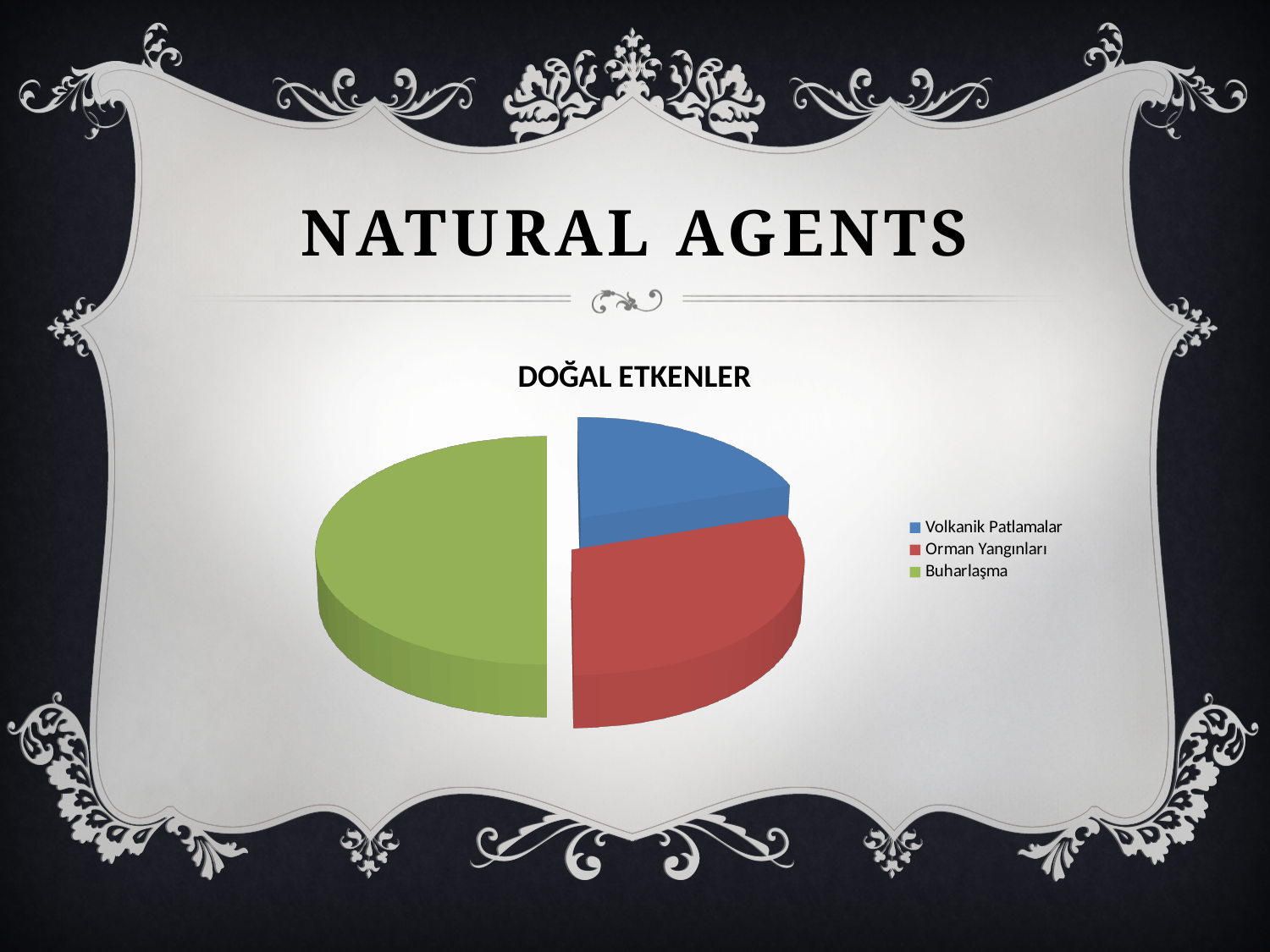
Which slice is larger, Buharlaşma or Orman Yangınları? Buharlaşma What kind of chart is shown on the slide? pie chart Which category has the largest slice of the pie? Buharlaşma Which slice is larger, Orman Yangınları or Volkanik Patlamalar? Orman Yangınları How many slices does the pie chart have? 3 Which colour represents Orman Yangınları in the pie chart? red Which category has the smallest slice of the pie? Volkanik Patlamalar How many entries does the legend list? 3 What is the title of the chart? DOĞAL ETKENLER